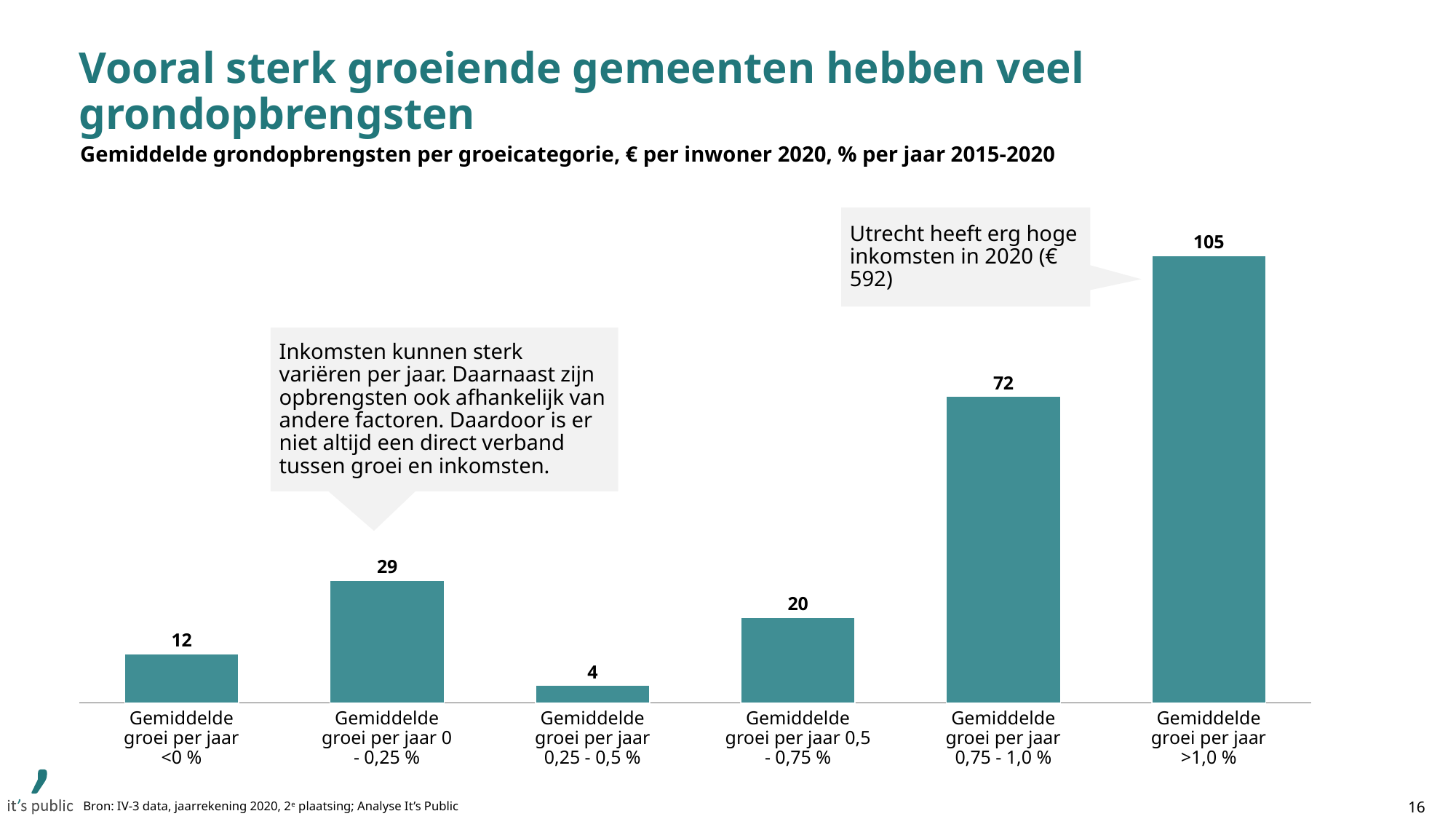
What is the value for the category 'Gemiddelde groei per jaar 0,75 - 1,0 %'? 72 Which category has the highest value? Gemiddelde groei per jaar >1,0 % What kind of chart is shown on the slide? Bar chart What is the subtitle of the chart? Gemiddelde grondopbrengsten per groeicategorie, € per inwoner 2020, % per jaar 2015-2020 How many categories are shown in the chart? 6 What is the value for the category 'Gemiddelde groei per jaar 0 - 0,25 %'? 29 Which category has the lowest value? Gemiddelde groei per jaar 0,25 - 0,5 % Which is larger: the value for 'Gemiddelde groei per jaar 0 - 0,25 %' or for 'Gemiddelde groei per jaar 0,5 - 0,75 %'? Gemiddelde groei per jaar 0 - 0,25 % What is the value for the category 'Gemiddelde groei per jaar <0 %'? 12 What is the value for the category 'Gemiddelde groei per jaar 0,25 - 0,5 %'? 4 What is the difference between the values for 'Gemiddelde groei per jaar >1,0 %' and 'Gemiddelde groei per jaar 0,75 - 1,0 %'? 33 According to the callout on the chart, what were Utrecht's income in 2020? € 592